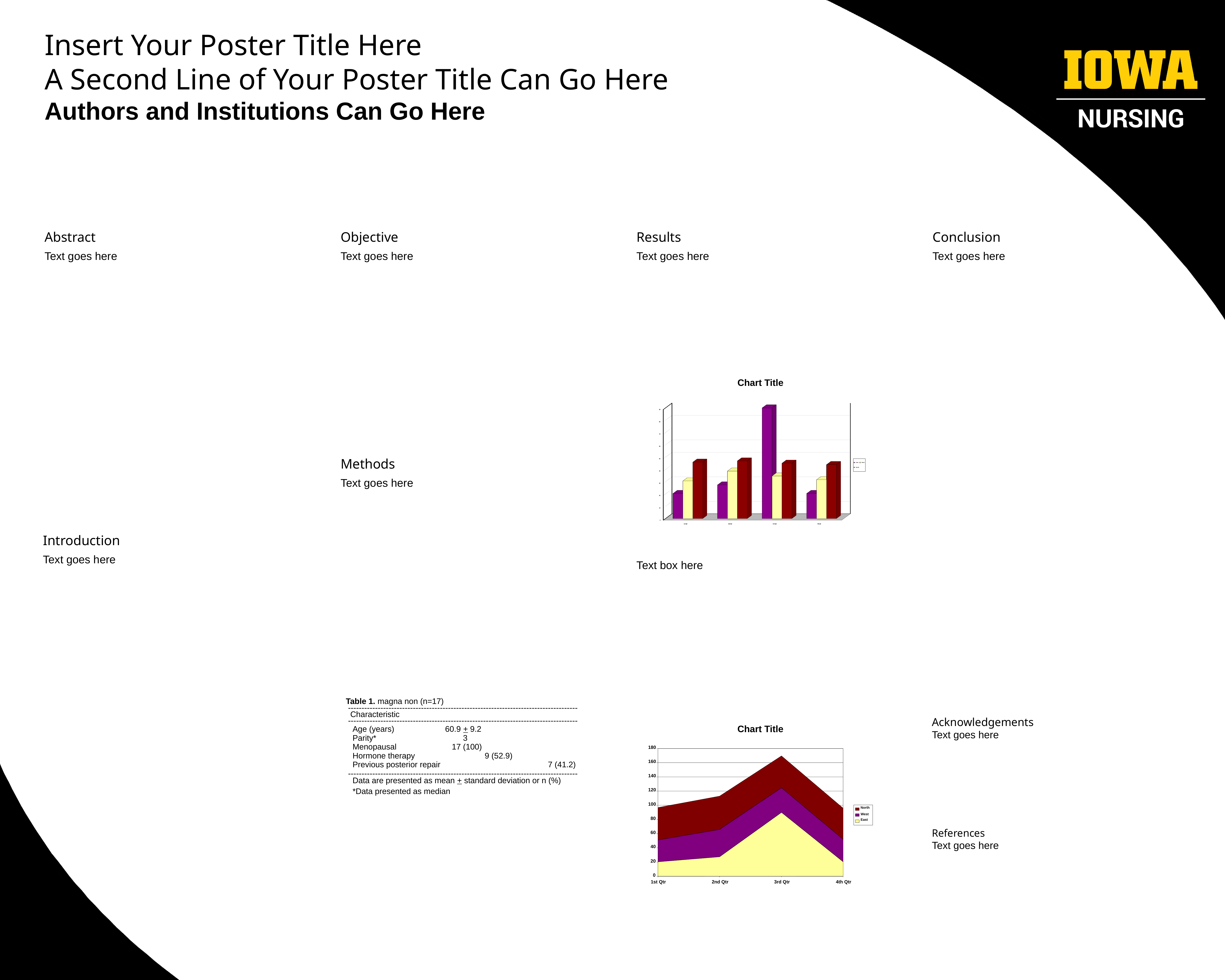
How many quarters are shown on the x axis of the lower chart? 4 How many bars are in each group of the upper chart? 3 In the lower chart, is the East value for 3rd Qtr greater or less than 80? greater In the lower chart, which quarter has the highest East value? 3rd Qtr In the lower chart, does the East series rise or fall from 1st Qtr to 3rd Qtr? rise In the lower chart, which quarter has the highest stacked total? 3rd Qtr In the lower chart, is the stacked total for 3rd Qtr greater or less than 160? greater What kind of chart is the upper chart on the slide? bar chart What kind of chart is the lower chart on the slide? area chart How many series does the legend of the lower chart list? 3 How many groups of bars does the upper chart show? 4 What are the series names in the legend of the lower chart? North, West, East